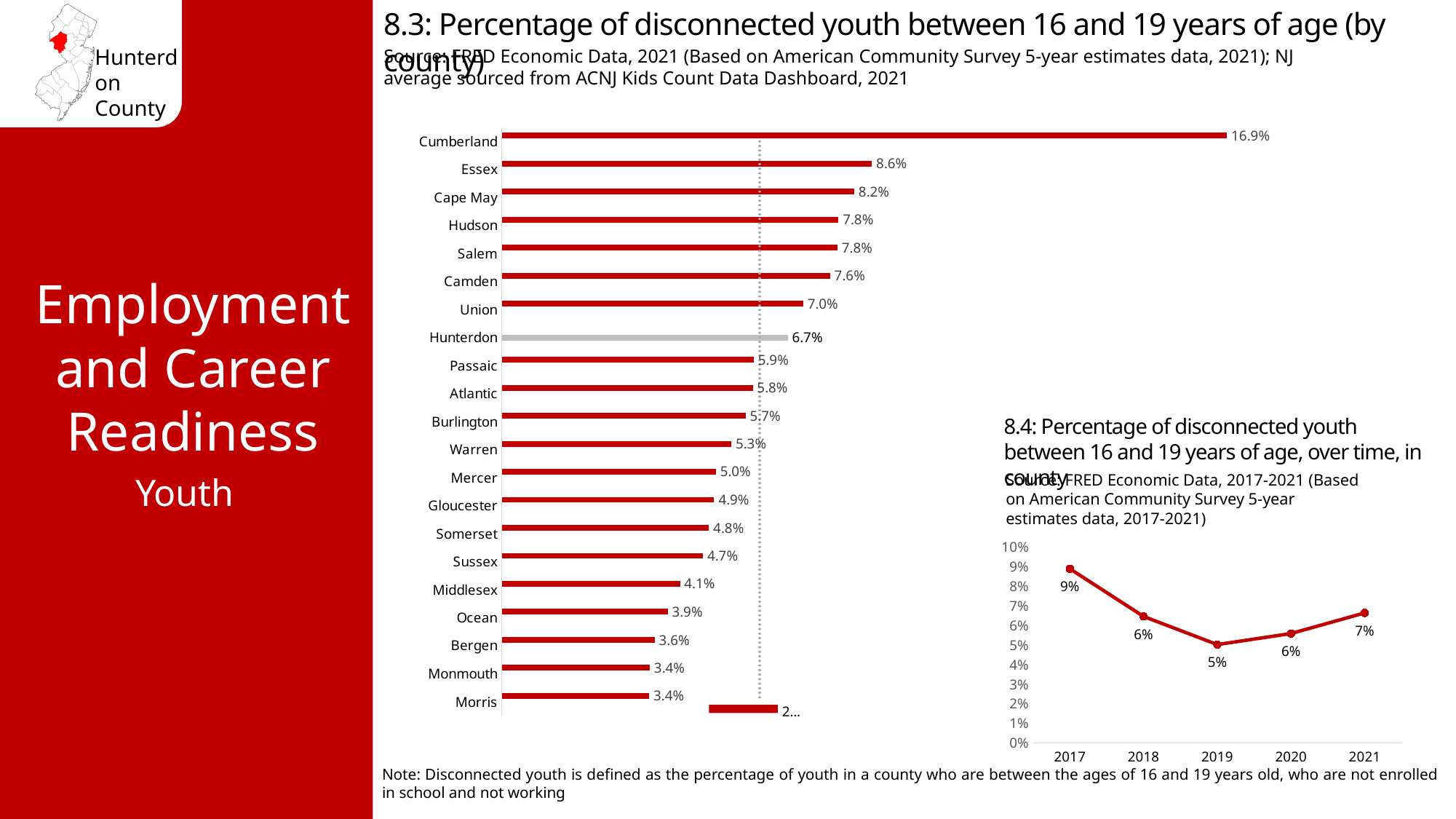
In chart 8.4, what is the percentage of disconnected youth in 2019? 5% In chart 8.3, which has a larger value, Union or Passaic? Union In chart 8.4, which year has the highest percentage of disconnected youth? 2017 In chart 8.3, how many counties are shown? 21 In chart 8.4, how many years are plotted? 5 In chart 8.3, what is the value for Middlesex? 4.1% In chart 8.4, does the value rise or fall from 2019 to 2021? Rise In chart 8.3, what is the percentage of disconnected youth for Hunterdon? 6.7% In chart 8.3, which county has the highest percentage of disconnected youth? Cumberland In chart 8.3, what is the difference between the values for Essex and Cape May? 0.4% What kind of chart is chart 8.3? Bar chart In chart 8.3, what is the percentage of disconnected youth for Cumberland? 16.9%